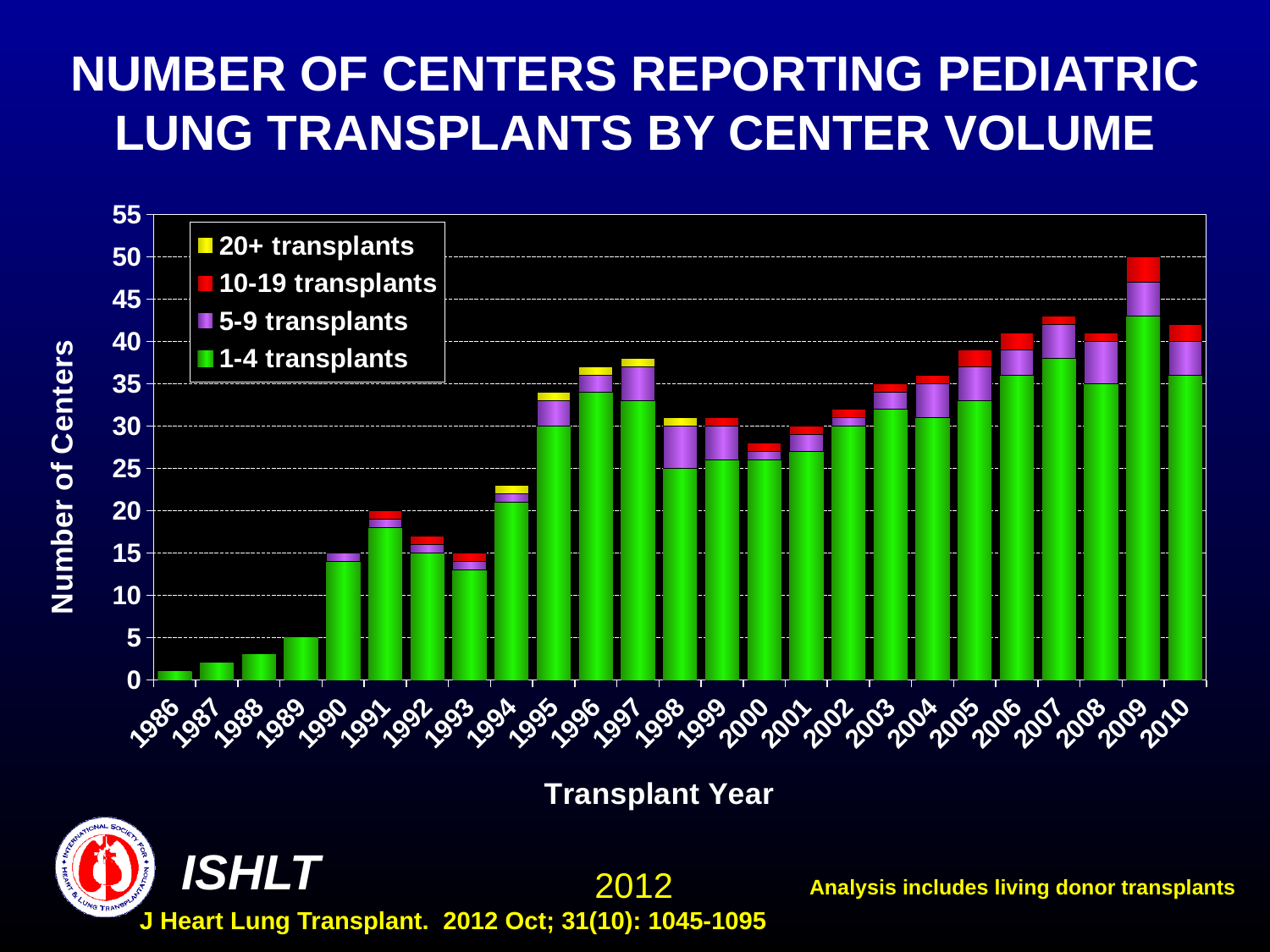
How many transplant years are shown on the x axis? 25 Which year has a larger total number of centers, 1991 or 1992? 1991 Do the total numbers of centers rise or fall from 1997 to 2000? fall Which year has a larger total number of centers, 2009 or 2010? 2009 Is the total number of centers for 1986 greater or less than 5? less How many series does the legend list? 4 Is the total number of centers for 2000 greater or less than 30? less Which transplant year has the lowest total number of centers? 1986 Is the total number of centers for 2009 greater or less than 45? greater Which transplant year has the highest total number of centers? 2009 What kind of chart is shown on the slide? Stacked bar chart What colour represents the 20+ transplants series in the legend? Yellow